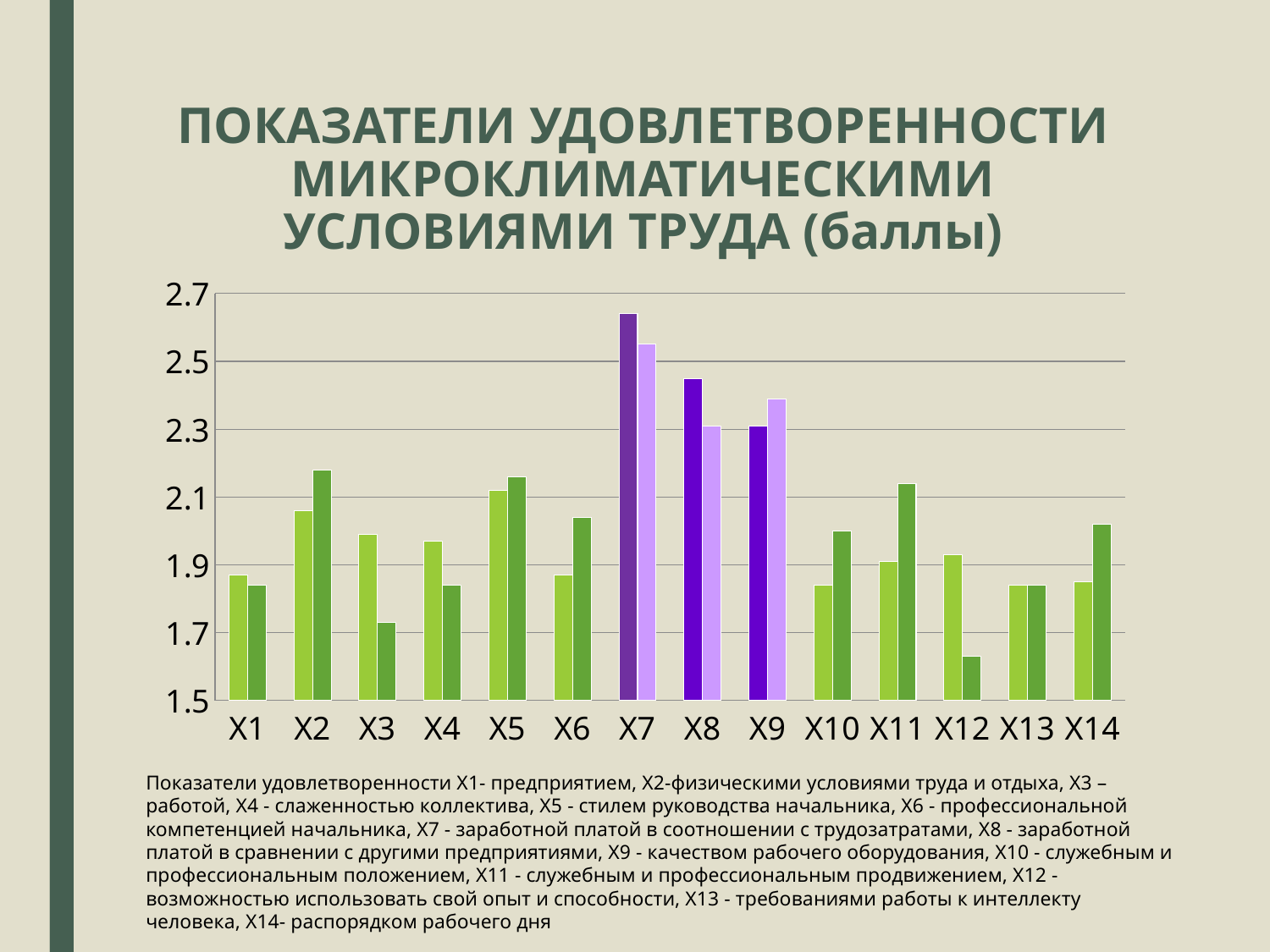
What colour are the bars for categories X7, X8 and X9, in contrast to the other categories? purple What kind of chart is shown on the slide? bar chart Is the value of the first (left) bar for X7 greater or less than 2.5? greater How many bars are plotted for each category? 2 Which category contains the shortest bar in the chart? X12 For category X3, which bar is taller, the first (left) or the second (right)? the first (left) Is the value of the second (right) bar for X2 greater or less than 2.1? greater How many categories are shown along the x axis? 14 Is the value of the second (right) bar for X12 greater or less than 1.7? less Which is larger: the first (left) bar for X7 or the first (left) bar for X8? X7 Which category contains the tallest bar in the chart? X7